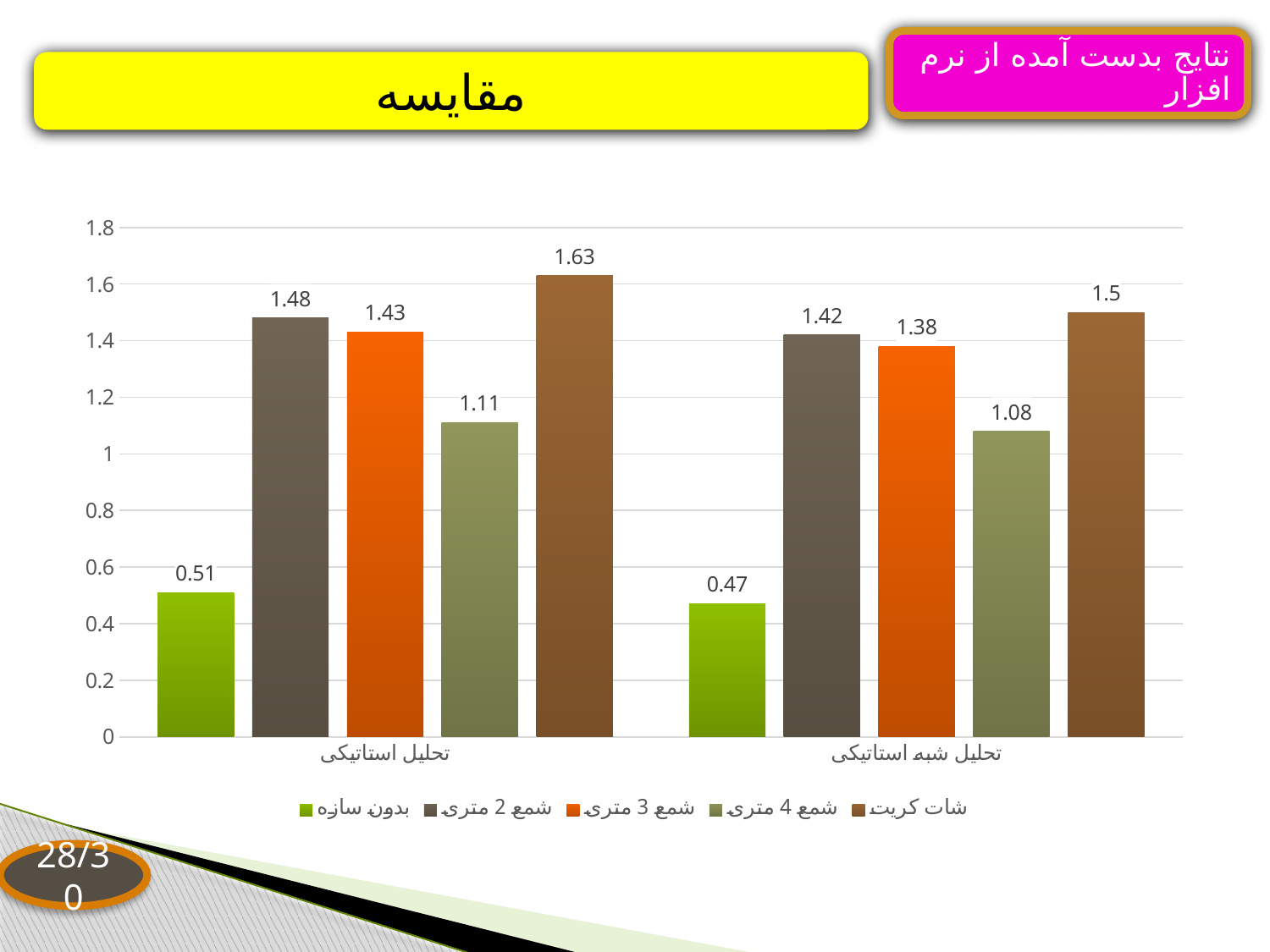
What type of chart is shown on the slide? bar chart Which is larger: شمع 2 متری for تحلیل استاتیکی or شمع 3 متری for تحلیل شبه استاتیکی? شمع 2 متری for تحلیل استاتیکی Which series has the highest value in the تحلیل شبه استاتیکی category? شات کریت What is the value of بدون سازه for تحلیل شبه استاتیکی? 0.47 How many categories are shown on the x axis? 2 How many series does the legend list? 5 What is the value of شمع 4 متری for تحلیل استاتیکی? 1.11 What is the difference between the شات کریت values for تحلیل استاتیکی and تحلیل شبه استاتیکی? 0.13 Is the value of شمع 4 متری for تحلیل شبه استاتیکی greater or less than 1.2? less What colour are the bars for the بدون سازه series? green What is the value of شات کریت for تحلیل استاتیکی? 1.63 Which series has the lowest value in the تحلیل استاتیکی category? بدون سازه